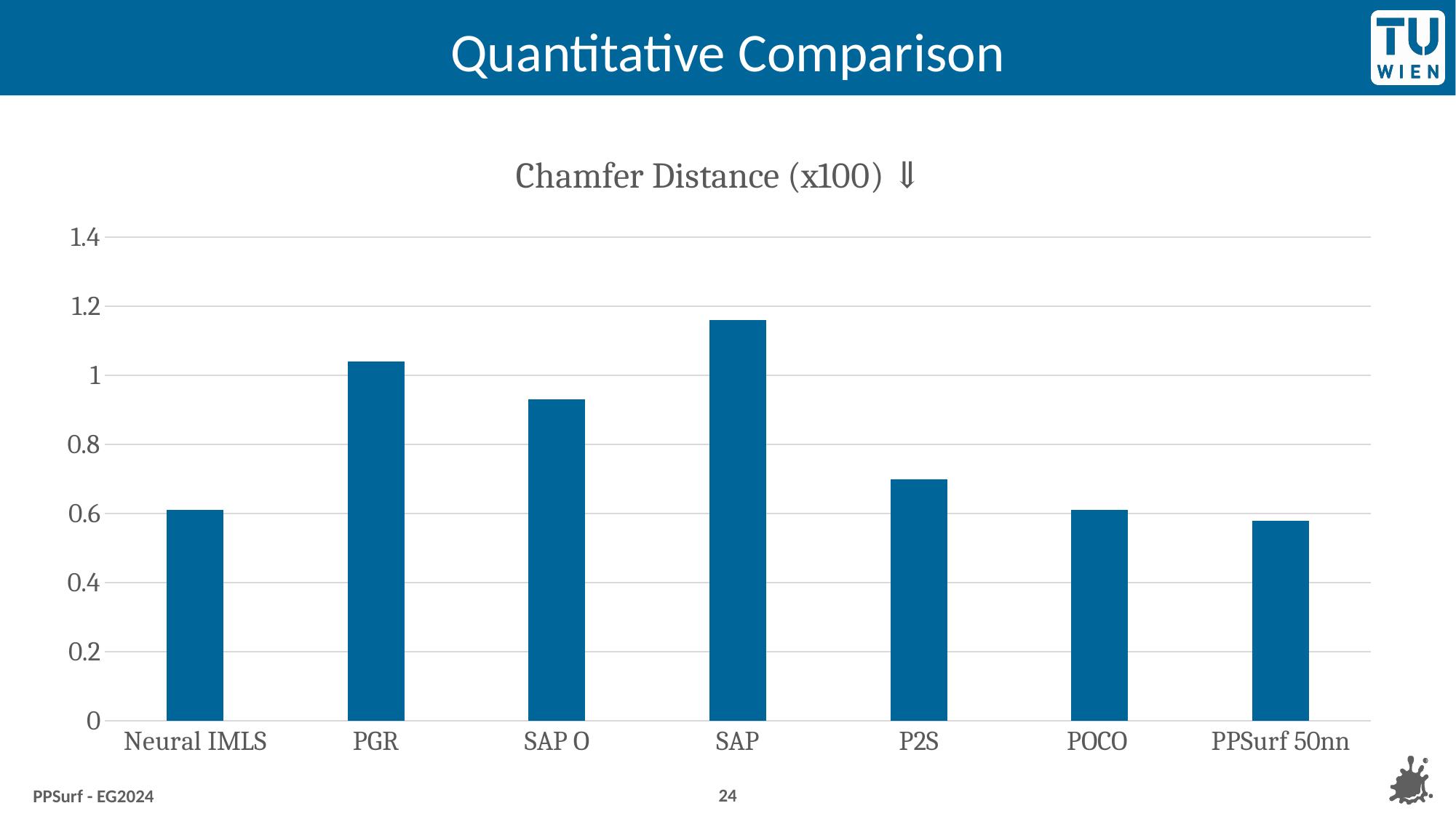
Is the value for POCO greater or less than 0.8? less How many methods (categories) are shown on the x axis of the chart? 7 Is the value for PPSurf 50nn greater or less than 0.8? less Which has the larger Chamfer Distance, PGR or SAP O? PGR Which method has the highest Chamfer Distance in the chart? SAP Is the value for SAP O greater or less than 1? less What colour are the bars in the chart? blue Which has the larger Chamfer Distance, P2S or POCO? P2S What kind of chart is shown on the slide? bar chart What is the title of the chart? Chamfer Distance (x100) ⇓